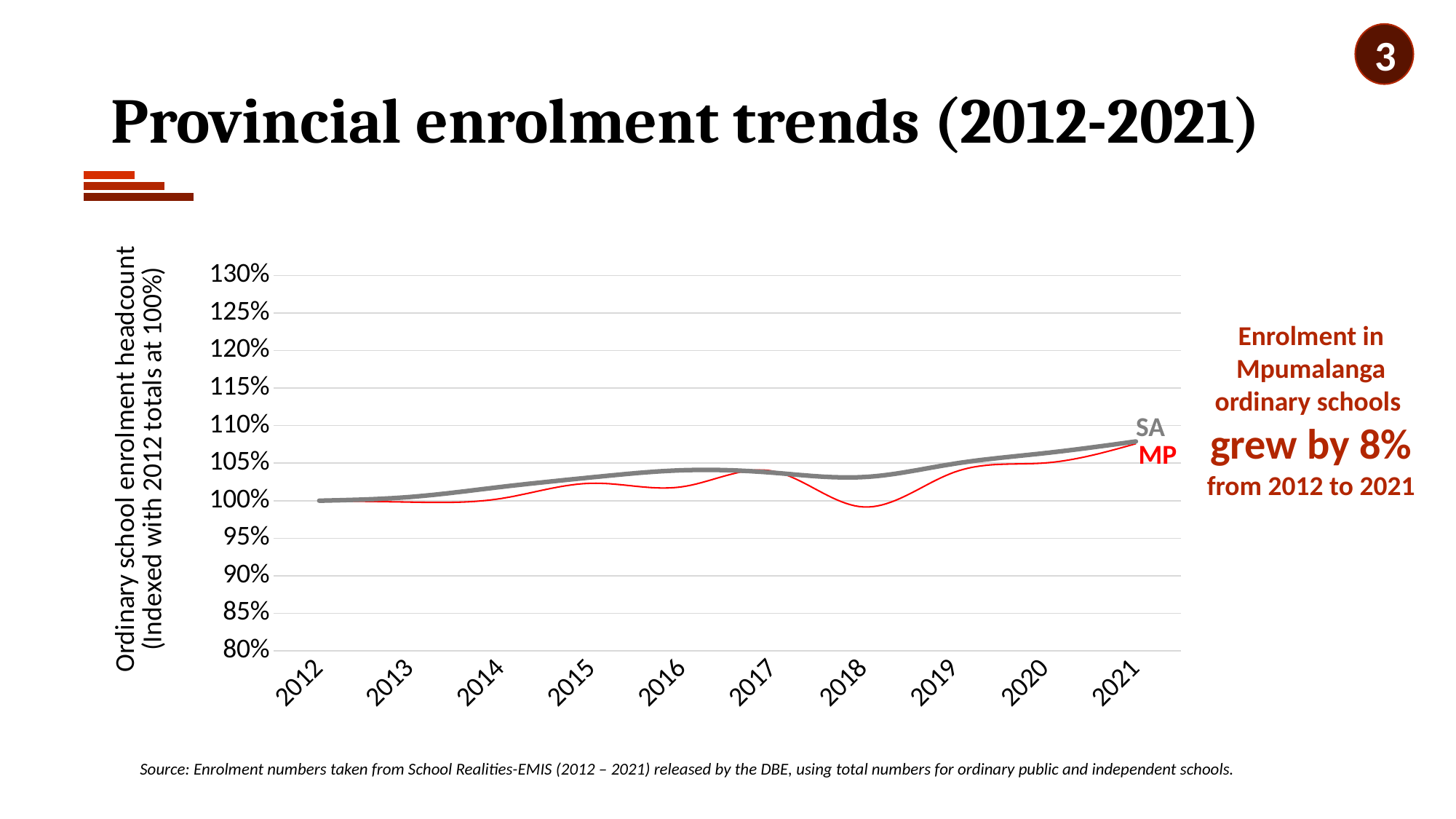
Does the SA series rise or fall overall from 2012 to 2021? rise In which year does the MP series reach its lowest point? 2018 In 2018, which series has the higher value, SA or MP? SA How many series are plotted on the chart? 2 Is the value for SA in 2021 greater or less than 105%? greater What is the title of the chart's vertical axis? Ordinary school enrolment headcount (Indexed with 2012 totals at 100%) How many years are shown along the x axis of the chart? 10 What kind of chart is shown on the slide? line chart In which year does the SA series reach its highest point? 2021 What is the value of the SA series in 2012? 100% Is the value for MP in 2018 greater or less than 105%? less What is the value of the MP series in 2012? 100%